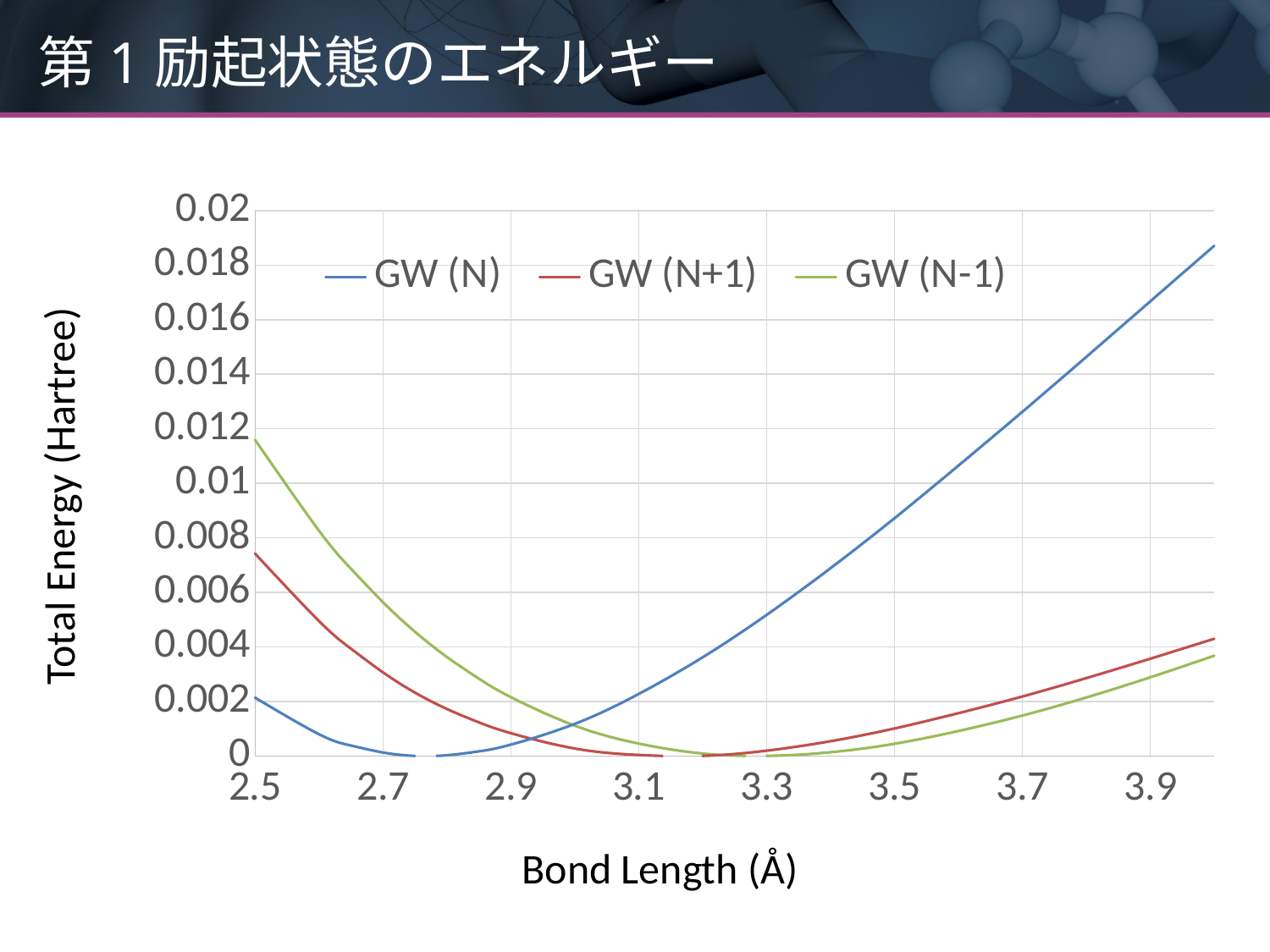
Does the GW (N) series rise or fall as the bond length increases from 3.1 to 3.9? rise What is the title of the horizontal axis? Bond Length (Å) Is the value of GW (N) at a bond length of 3.9 greater or less than 0.014? greater What is the title of the vertical axis? Total Energy (Hartree) Is the value of GW (N) at a bond length of 2.5 greater or less than 0.004? less How many series does the legend list? 3 Is the value of GW (N+1) at a bond length of 2.5 greater or less than 0.008? less What kind of chart is shown on the slide? line chart At a bond length of 3.9, which series has the higher value, GW (N) or GW (N+1)? GW (N) Which series has the lowest value at a bond length of 2.5? GW (N) At a bond length of 2.5, which series has the higher value, GW (N-1) or GW (N+1)? GW (N-1)